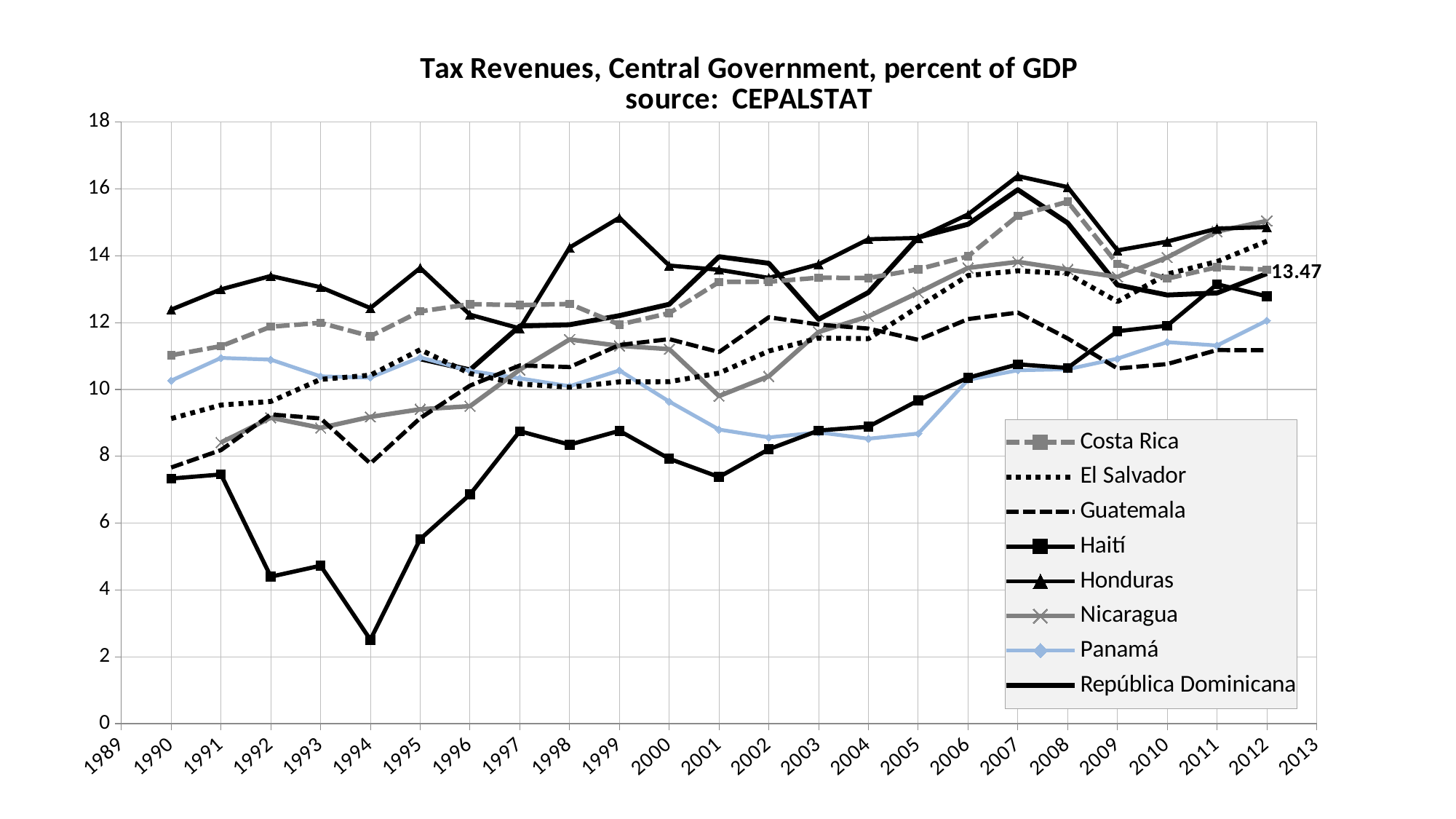
What is the labelled value for República Dominicana in 2012? 13.47 Which series has the lowest value in 1994? Haití What kind of chart is shown on the slide? line chart Is the value for Honduras in 2007 greater or less than 16? greater In 1990, which is larger: the value for Honduras or the value for Haití? Honduras What source is cited in the chart title? CEPALSTAT Does the Haití line rise or fall between 1994 and 1999? rise What is the title of the chart? Tax Revenues, Central Government, percent of GDP In which year does the Haití line reach its lowest point? 1994 Which series has the highest value in 2007? Honduras How many series does the legend list? 8 Is the value for Haití in 1994 greater or less than 4? less